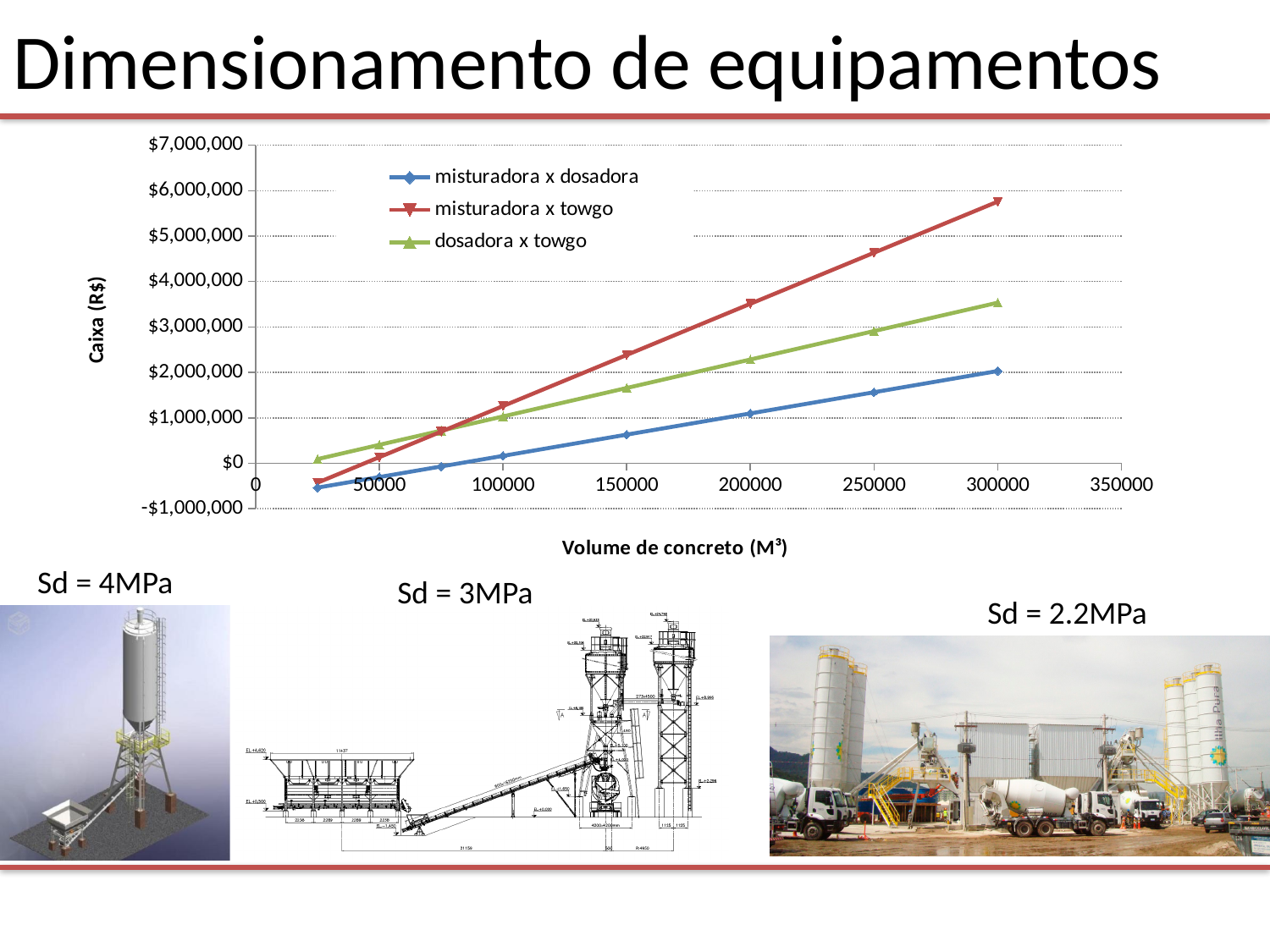
How many series does the chart legend list? 3 Is the value of misturadora x dosadora at a volume of 25000 greater or less than $0? less Is the value of misturadora x towgo at a volume of 300000 greater or less than $5,000,000? greater At a volume of 200000, which series has the larger value: misturadora x towgo or misturadora x dosadora? misturadora x towgo At a volume of 50000, which series has the larger value: dosadora x towgo or misturadora x towgo? dosadora x towgo Is the value of misturadora x towgo at a volume of 200000 greater or less than $3,000,000? greater What kind of chart is shown on the slide? line chart Which series has the lowest value at a volume of 300000? misturadora x dosadora What is the title of the vertical axis of the chart? Caixa (R$) Which series has the highest value at a volume of 300000? misturadora x towgo Do the values of the misturadora x towgo series rise or fall as the volume of concrete increases? rise